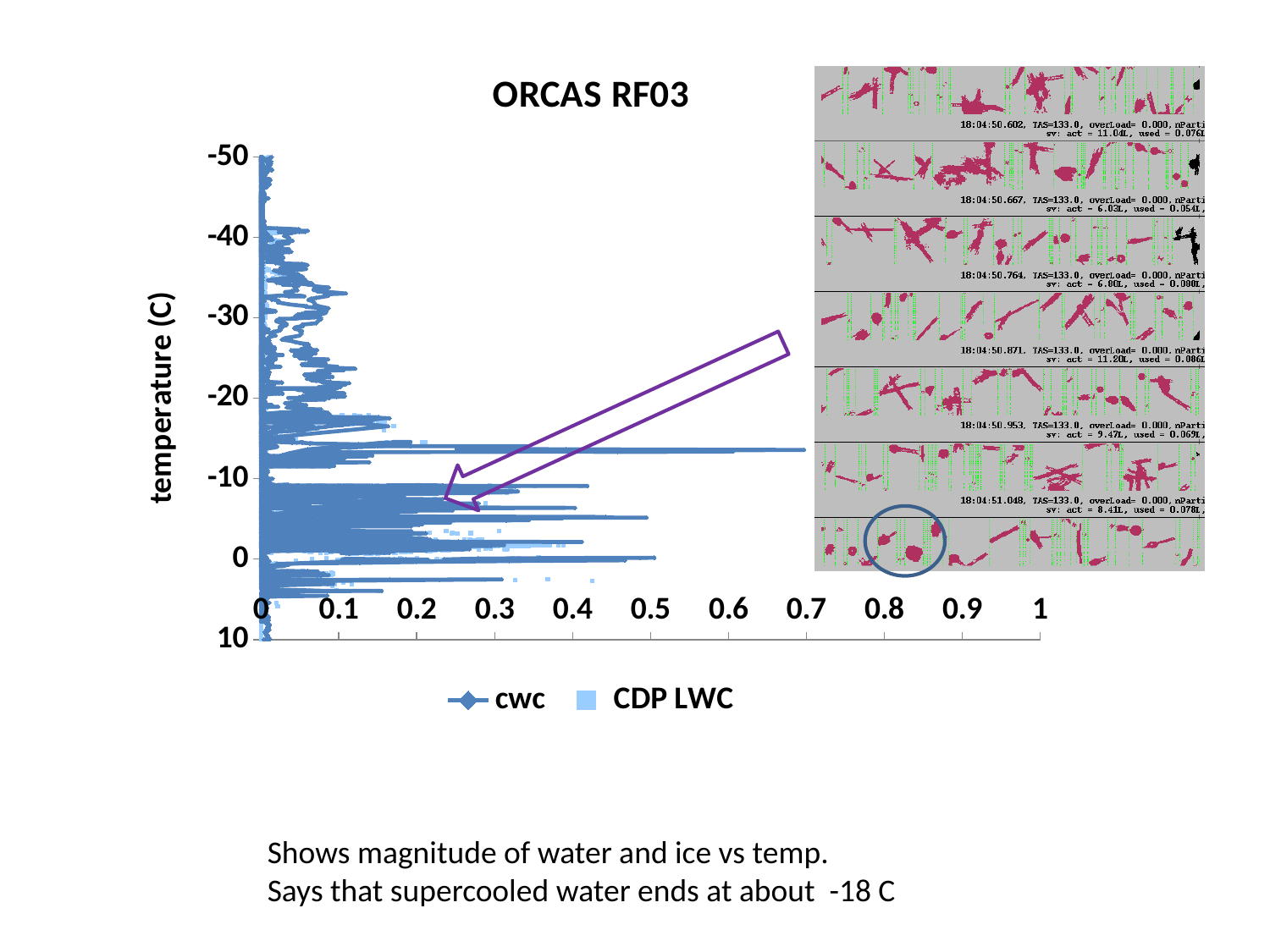
What is the highest value shown on the horizontal axis of the chart? 1 Is the cwc value at a temperature of -45 C greater or less than 0.1? less What is the title of the chart? ORCAS RF03 Which series is plotted with light blue square markers? CDP LWC Is the largest cwc value plotted on the chart greater or less than 0.6? greater What is the label on the vertical axis of the chart? temperature (C) Is the largest cwc value plotted on the chart greater or less than 0.8? less What is the highest temperature tick shown on the vertical axis of the chart? 10 What are the names of the two series in the chart legend? cwc and CDP LWC How many series does the chart legend list? 2 What is the lowest temperature tick shown on the vertical axis of the chart? -50